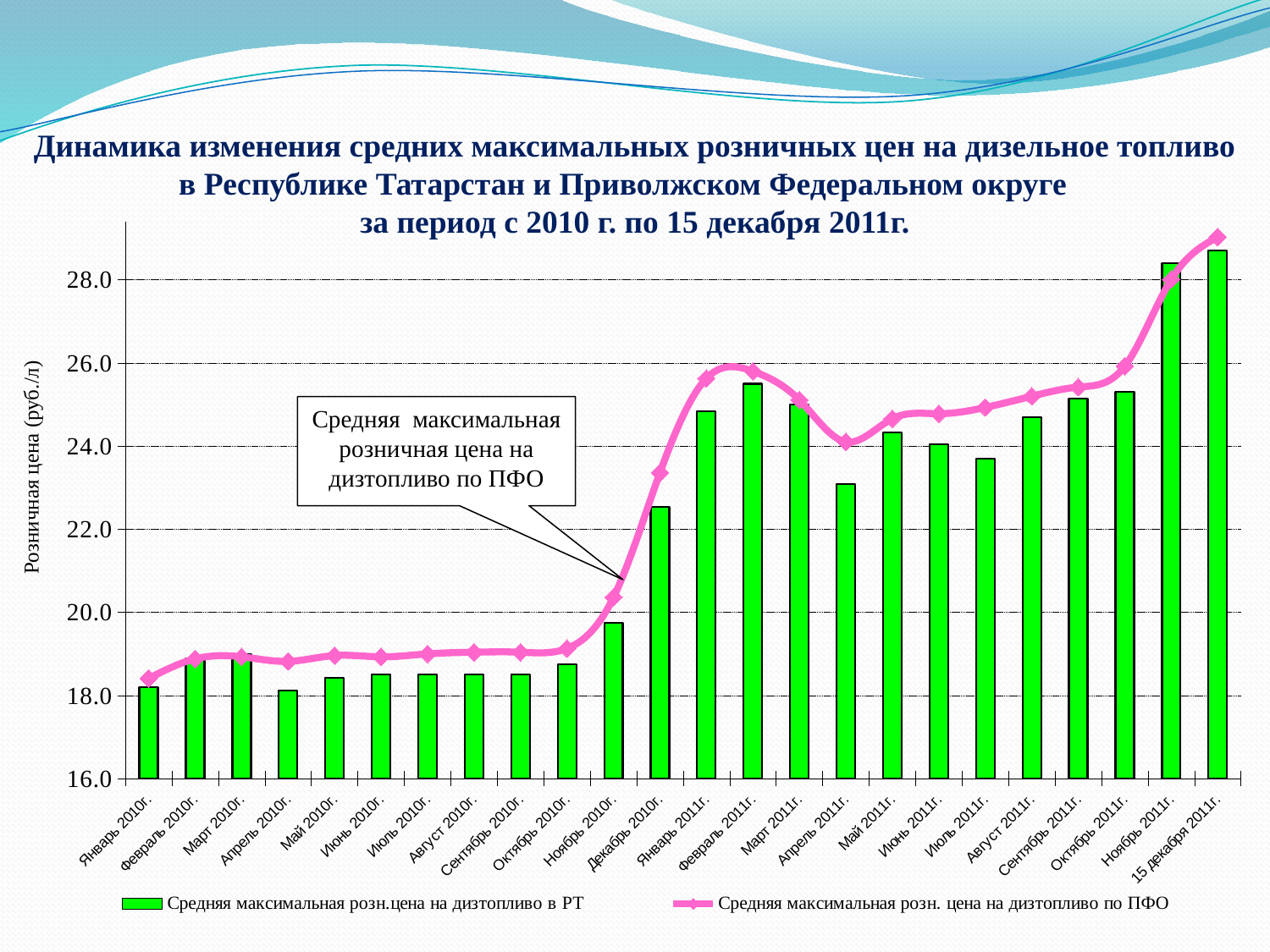
Overall, do the bar values rise or fall from Январь 2010г. to 15 декабря 2011г.? rise Is the bar value for Декабрь 2010г. greater or less than 22.0? greater How many series does the legend list? 2 Is the bar value for Апрель 2011г. greater or less than 24.0? less Which month has the highest bar for the average maximum retail diesel price in RT? 15 декабря 2011г. How many months (categories) are shown along the x axis? 24 Which bar is taller: Февраль 2011г. or Март 2011г.? Февраль 2011г. What is the label of the vertical axis? Розничная цена (руб./л) What kind of chart is shown on the slide? A combined bar and line chart Is the bar value for Ноябрь 2011г. greater or less than 28.0? greater